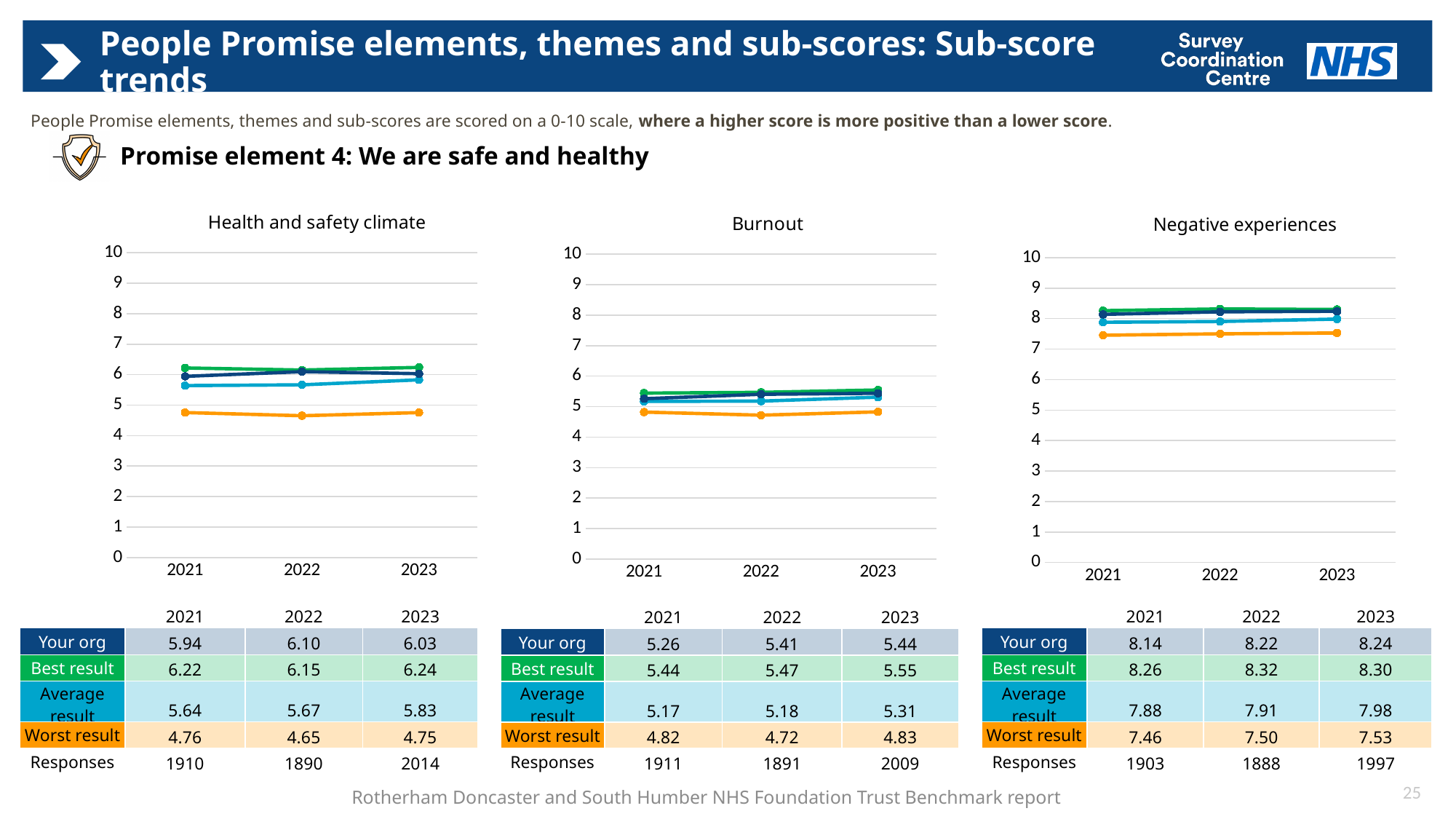
In the Negative experiences chart, does the Average result rise or fall from 2021 to 2023? rise What kind of chart is the Burnout chart? line chart In the Burnout chart, which is higher in 2023: Your org or Average result? Your org In the Burnout chart, by how much did the Your org score change from 2021 to 2023? 0.18 How many years are shown on the x axis of the Health and safety climate chart? 3 In the Negative experiences chart, what is the Best result score for 2022? 8.32 In the Negative experiences chart, in which year is the Your org score highest? 2023 In the Health and safety climate chart, in which year is the Worst result score lowest? 2022 In the Health and safety climate chart, what is the difference between the Best result and the Worst result in 2021? 1.46 In the Negative experiences chart, is the Worst result value for 2021 greater or less than 7? greater In the Burnout chart, what is the Worst result score for 2022? 4.72 In the Health and safety climate chart, what is the Your org score for 2023? 6.03